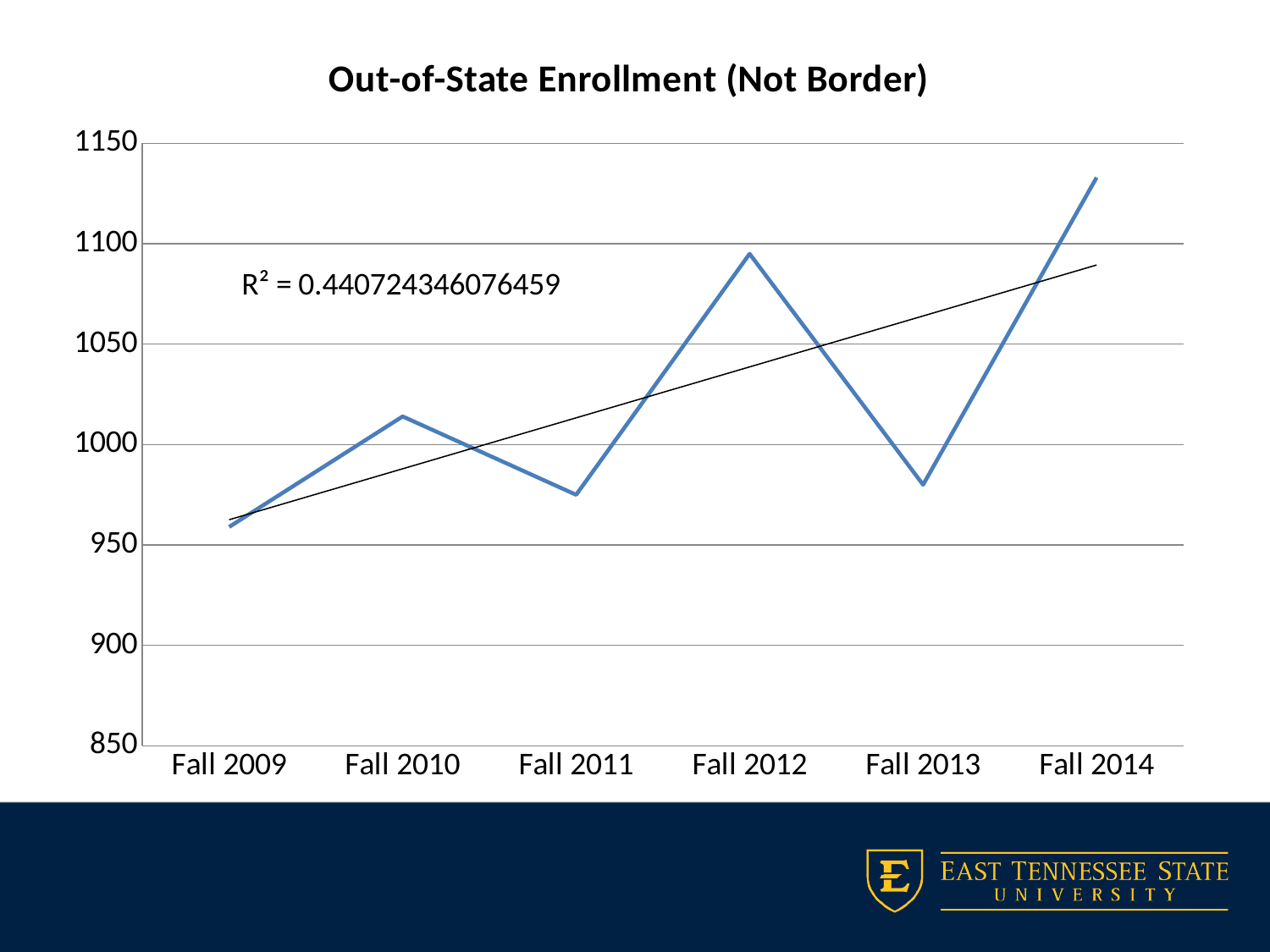
Is the value for Fall 2009 greater or less than 1000? less What R² value is printed on the chart? R² = 0.440724346076459 How many data points (semesters) are plotted on the x axis? 6 Does the trend line show enrollment rising or falling from Fall 2009 to Fall 2014? rising What kind of chart is shown on the slide? line chart Is the value for Fall 2013 greater or less than 1000? less Is the value for Fall 2014 greater or less than 1100? greater Which is larger, the value for Fall 2012 or the value for Fall 2010? Fall 2012 Which semester has the highest out-of-state enrollment? Fall 2014 What is the title of the chart? Out-of-State Enrollment (Not Border)